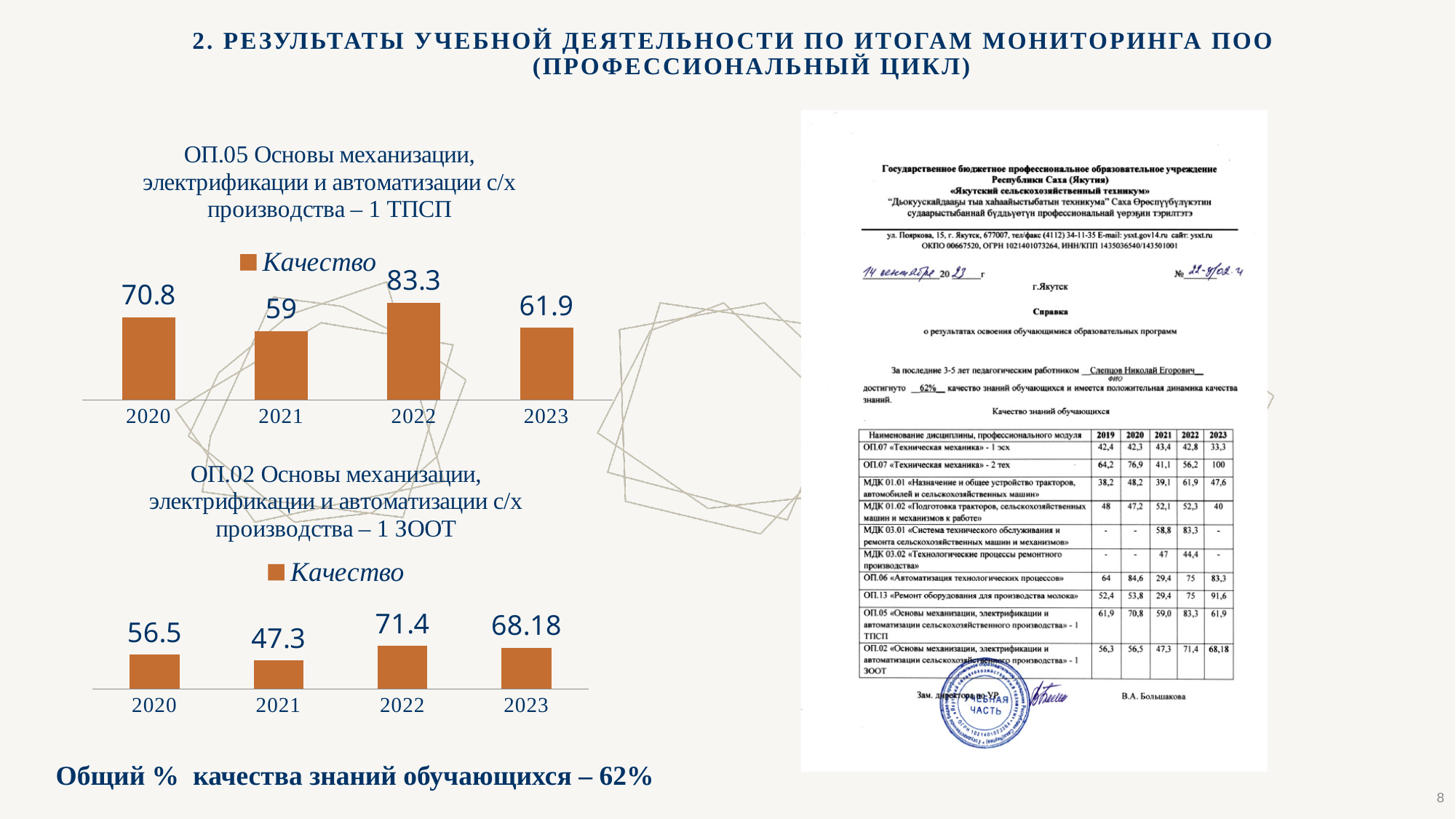
In the top chart (ОП.05, 1 ТПСП), what is the difference between the 2020 and 2023 values? 8.9 What type of chart is the top chart (ОП.05, 1 ТПСП)? Bar chart How many years are shown on the x axis of the bottom chart (ОП.02, 1 ЗООТ)? 4 In the top chart (ОП.05, 1 ТПСП), which year has the lowest value? 2021 In the bottom chart (ОП.02, 1 ЗООТ), which is larger, the value for 2022 or the value for 2023? 2022 In the bottom chart (ОП.02, 1 ЗООТ), which year has the lowest value? 2021 In the top chart (ОП.05, 1 ТПСП), what is the value for 2021? 59 In the top chart (ОП.05, 1 ТПСП), which year has the highest value? 2022 In the bottom chart (ОП.02, 1 ЗООТ), what is the value for 2020? 56.5 In the top chart (ОП.05, 1 ТПСП), what is the value for 2022? 83.3 What is the legend entry shown for the bottom chart (ОП.02, 1 ЗООТ)? Качество In the bottom chart (ОП.02, 1 ЗООТ), what is the value for 2023? 68.18